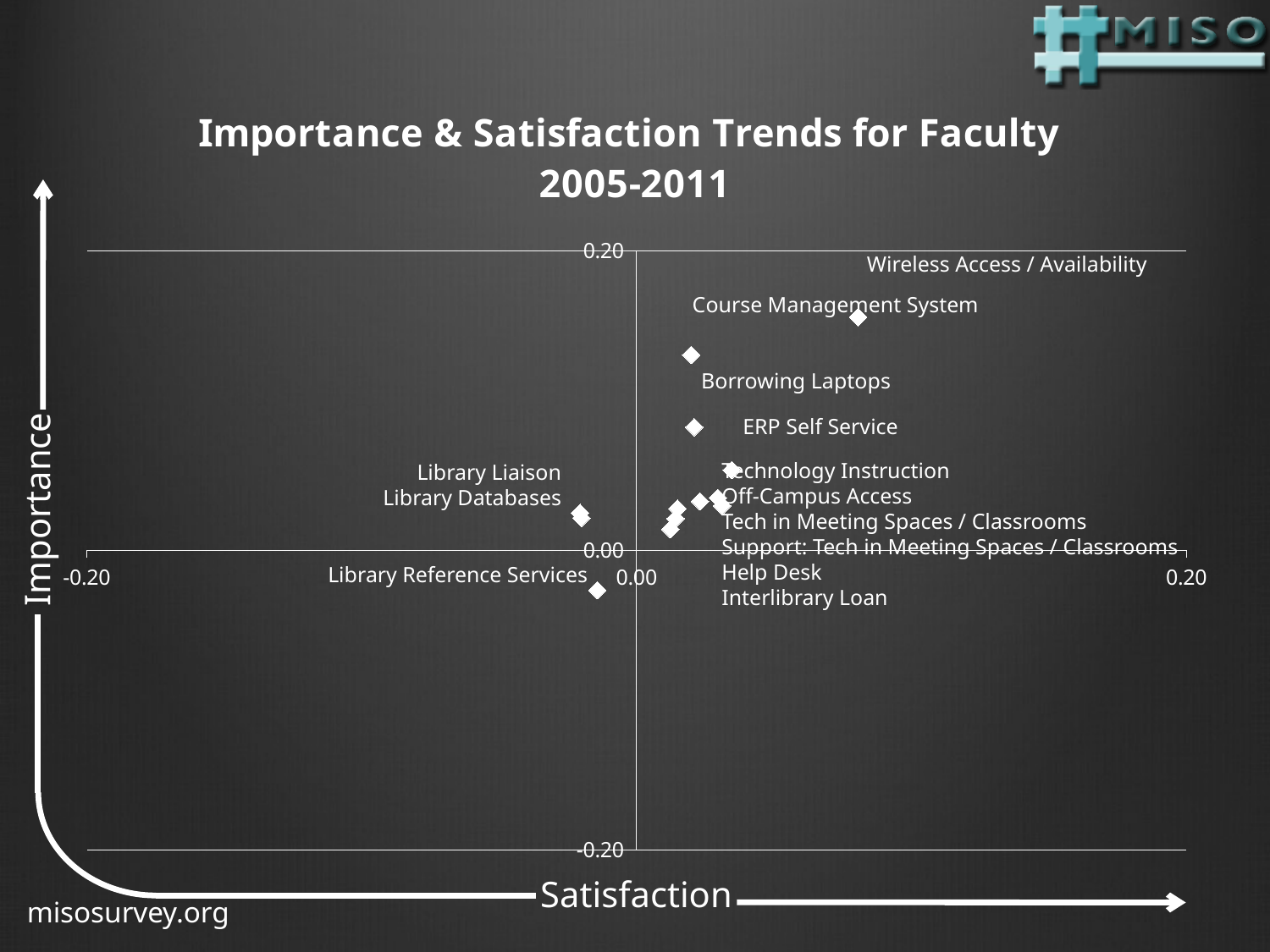
Is the satisfaction value for Library Reference Services greater or less than 0.00? less Which labeled service has the lowest importance value? Library Reference Services Is the importance value for Library Reference Services greater or less than 0.00? less Which has the higher satisfaction value, Wireless Access / Availability or Library Databases? Wireless Access / Availability What is the title of the chart? Importance & Satisfaction Trends for Faculty 2005-2011 What kind of chart is shown on the slide? scatter chart Is the importance value for Wireless Access / Availability greater or less than 0.00? greater Which labeled service has the highest satisfaction value? Wireless Access / Availability What does the vertical axis of the chart represent? Importance Which has the higher importance value, Course Management System or Borrowing Laptops? Course Management System Which labeled service has the highest importance value? Wireless Access / Availability